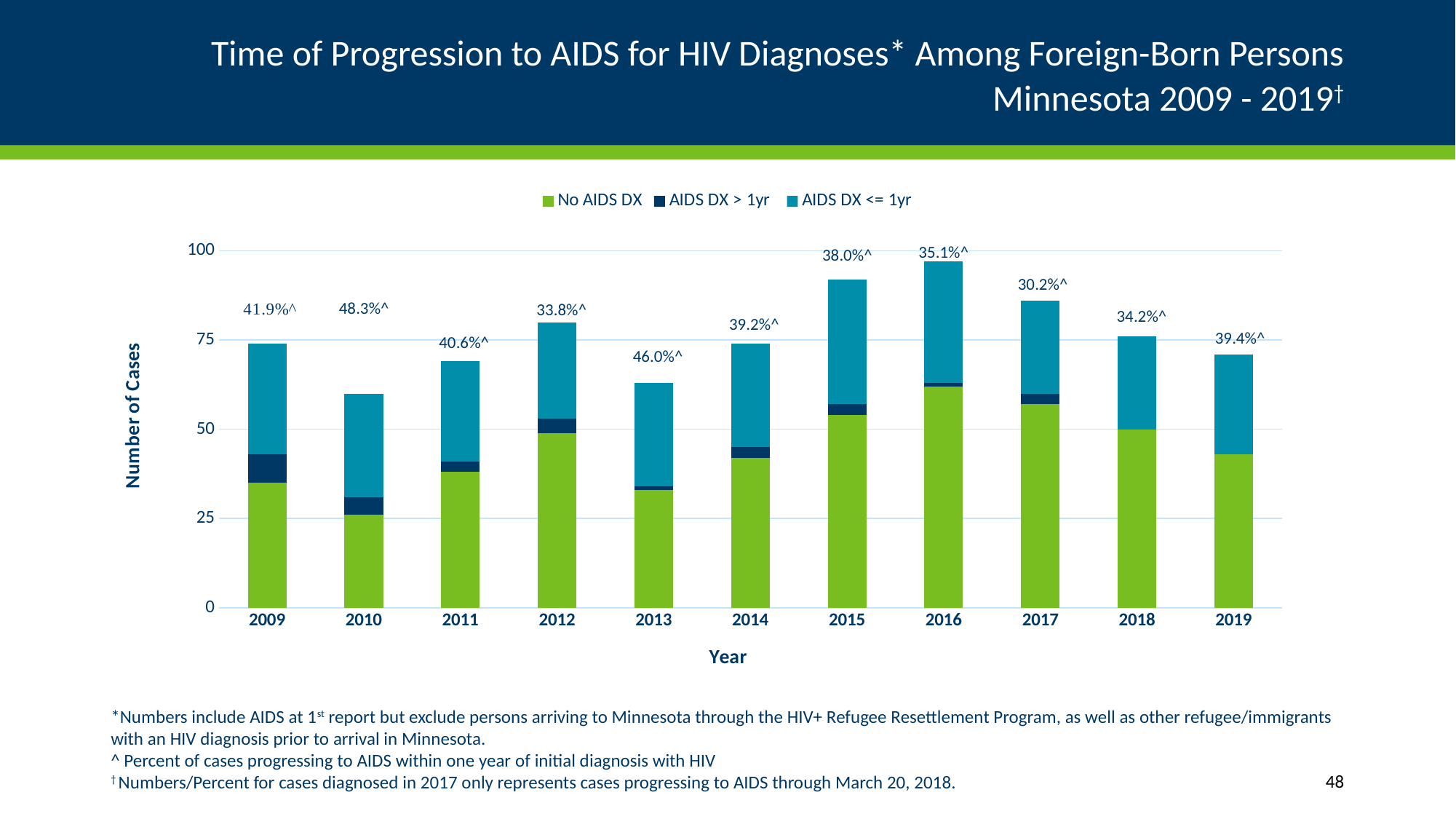
Which year has the lowest percentage of cases progressing to AIDS within one year? 2017 Is the total number of cases for 2010 greater or less than 75? less How many series does the legend list? 3 What percentage label is shown above the 2013 bar? 46.0%^ Which year has the tallest bar (most total cases)? 2016 Which year has the highest percentage of cases progressing to AIDS within one year? 2010 Is the total number of cases for 2016 greater or less than 75? greater What percentage label is shown above the 2010 bar? 48.3%^ How many years are shown on the x axis? 11 What percentage label is shown above the 2017 bar? 30.2%^ What is the difference between the percentage labels for 2010 and 2017? 18.1 percentage points Which year has a higher percentage label, 2013 or 2014? 2013